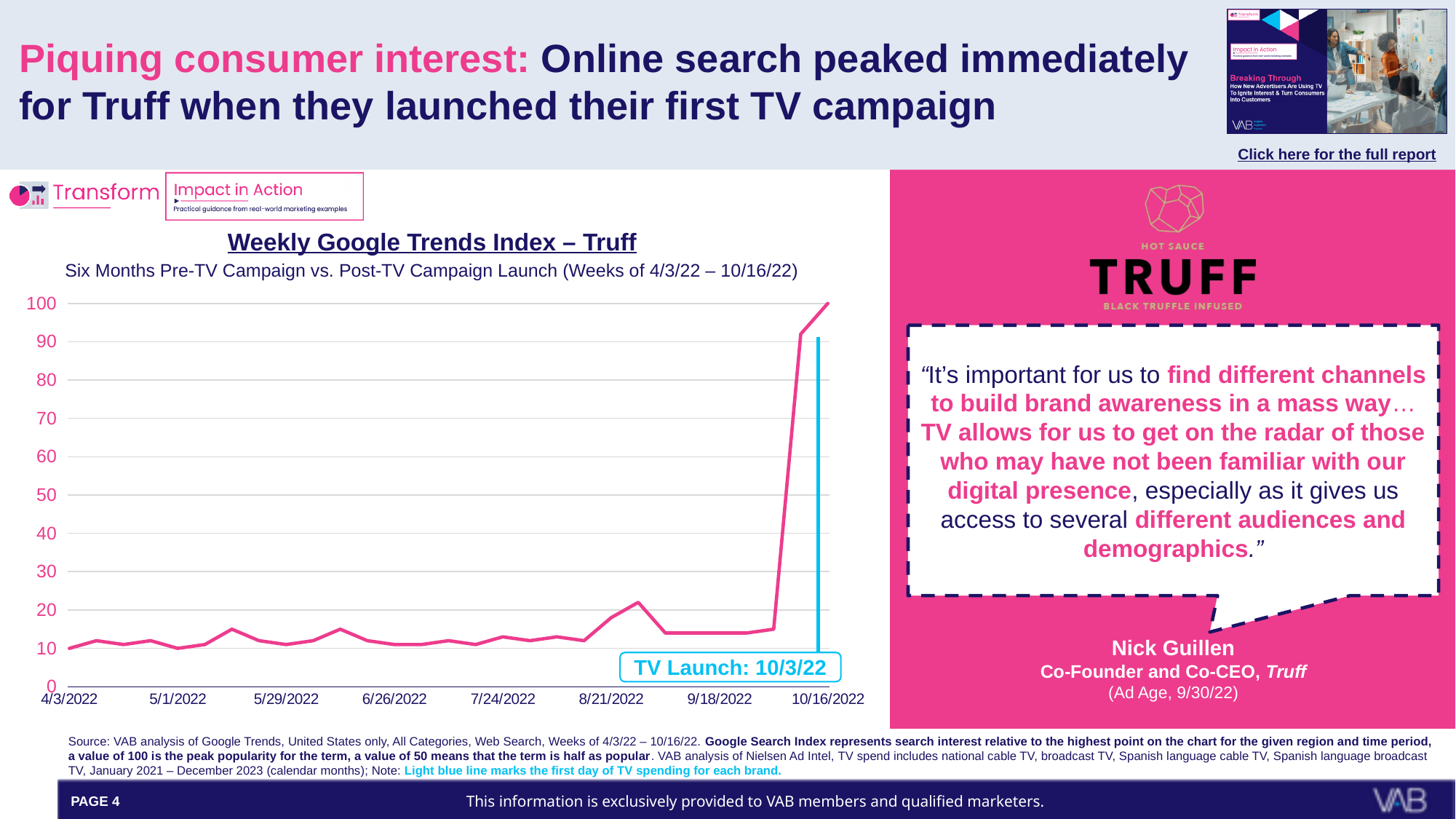
On which date does the Google Trends index reach its highest value? 10/16/2022 Is the value for 10/16/2022 greater or less than 90? greater Does the Google Trends index rise or fall from the start of the period to the end? rise Which is larger, the value for 10/16/2022 or the value for 4/3/2022? 10/16/2022 What is the Google Trends index value at 10/16/2022? 100 Is the value for 7/24/2022 greater or less than 20? less What date does the light blue vertical line on the chart mark as the TV launch? 10/3/22 What is the title of the chart? Weekly Google Trends Index – Truff How many date labels are shown on the x axis? 8 Is the value for 4/3/2022 greater or less than 20? less What kind of chart is shown on the slide? line chart